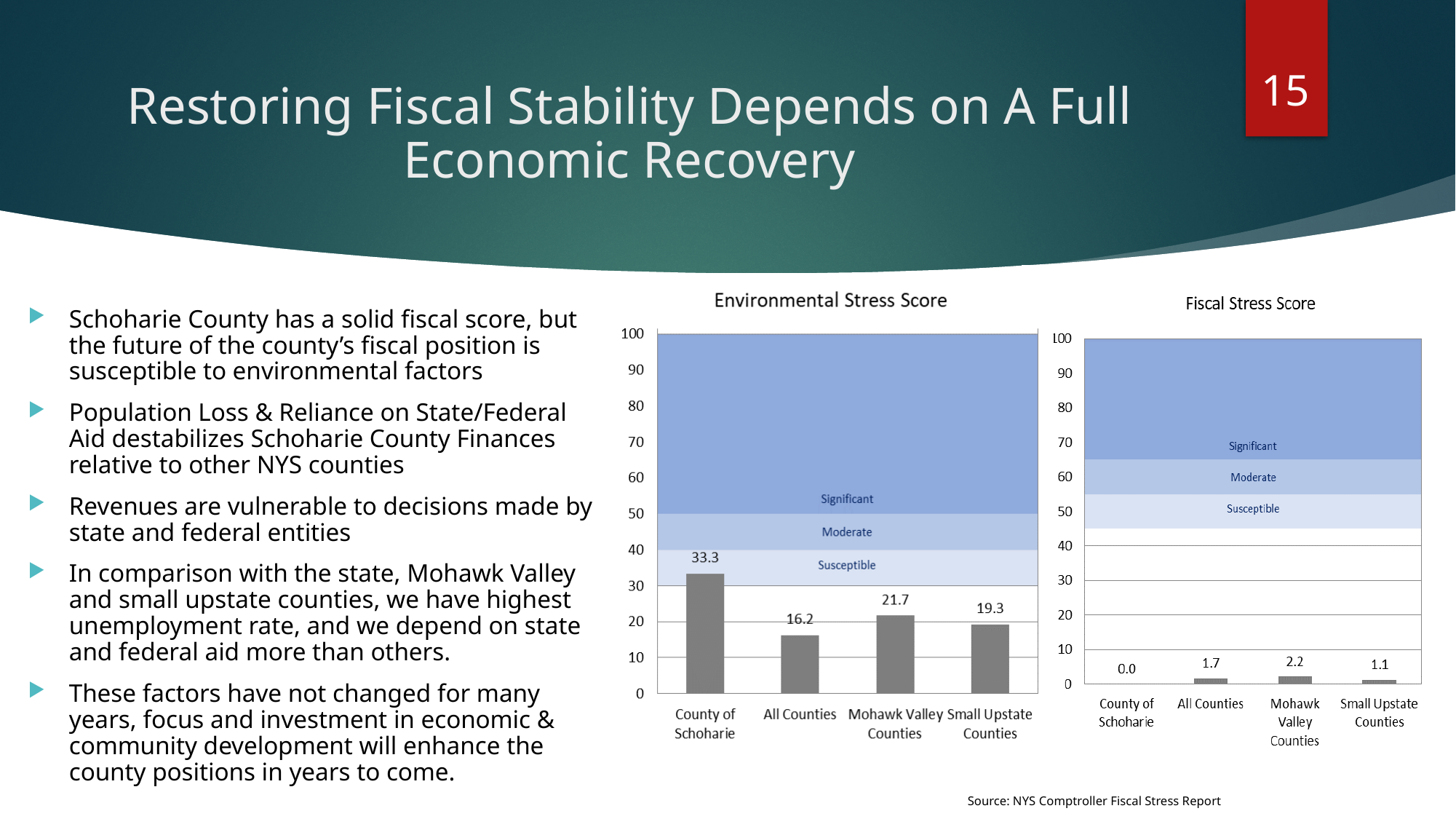
In the Environmental Stress Score chart, which is larger: the value for Mohawk Valley Counties or Small Upstate Counties? Mohawk Valley Counties In the Environmental Stress Score chart, what is the difference between the values for County of Schoharie and All Counties? 17.1 In the Fiscal Stress Score chart, what is the value for County of Schoharie? 0.0 What kind of chart is the Fiscal Stress Score chart? Bar chart In the Environmental Stress Score chart, which category has the highest value? County of Schoharie In the Environmental Stress Score chart, which category has the lowest value? All Counties How many categories are shown in the Environmental Stress Score chart? 4 In the Fiscal Stress Score chart, which category has the highest value? Mohawk Valley Counties In the Fiscal Stress Score chart, what is the value for Mohawk Valley Counties? 2.2 In the Fiscal Stress Score chart, what is the difference between the values for All Counties and Small Upstate Counties? 0.6 In the Environmental Stress Score chart, what is the value for All Counties? 16.2 In the Environmental Stress Score chart, what is the value for County of Schoharie? 33.3